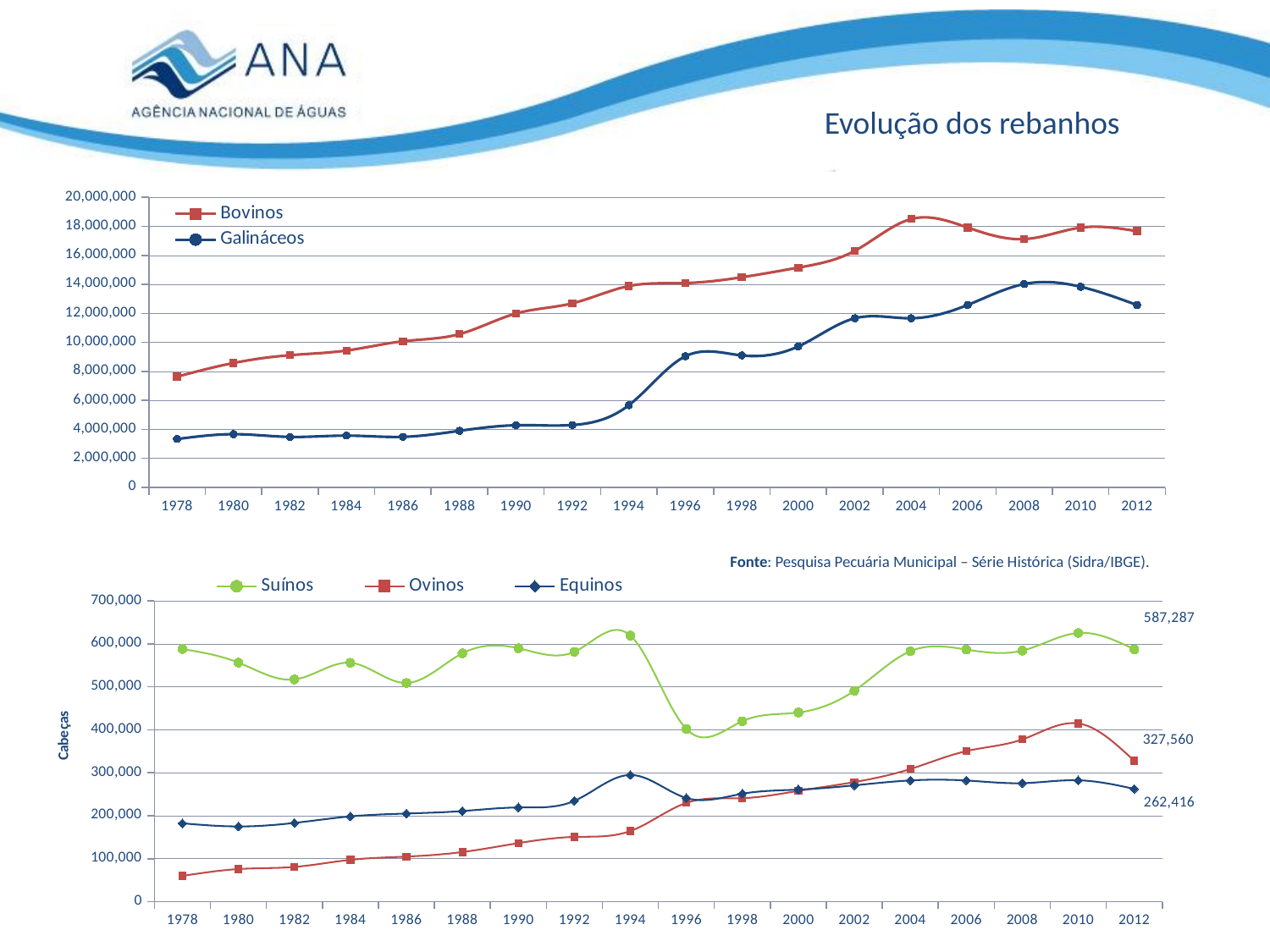
In the top chart, is the value for Bovinos in 2012 greater or less than 16,000,000? greater In the top chart, how many series does the legend list? 2 In the top chart, which series has the larger value in 2004, Bovinos or Galináceos? Bovinos In the bottom chart, what is the value for Equinos in 2012? 262,416 In the top chart, does the Galináceos series rise or fall between 1992 and 2008? rise In the bottom chart, how many series does the legend list? 3 In the bottom chart, what is the difference between the Suínos and Ovinos values in 2012? 259,727 In the bottom chart, what is the label on the vertical axis? Cabeças What kind of chart is the top chart? line chart In the bottom chart, what is the value for Suínos in 2012? 587,287 In the top chart, is the value for Galináceos in 1978 greater or less than 4,000,000? less In the bottom chart, what is the value for Ovinos in 2012? 327,560